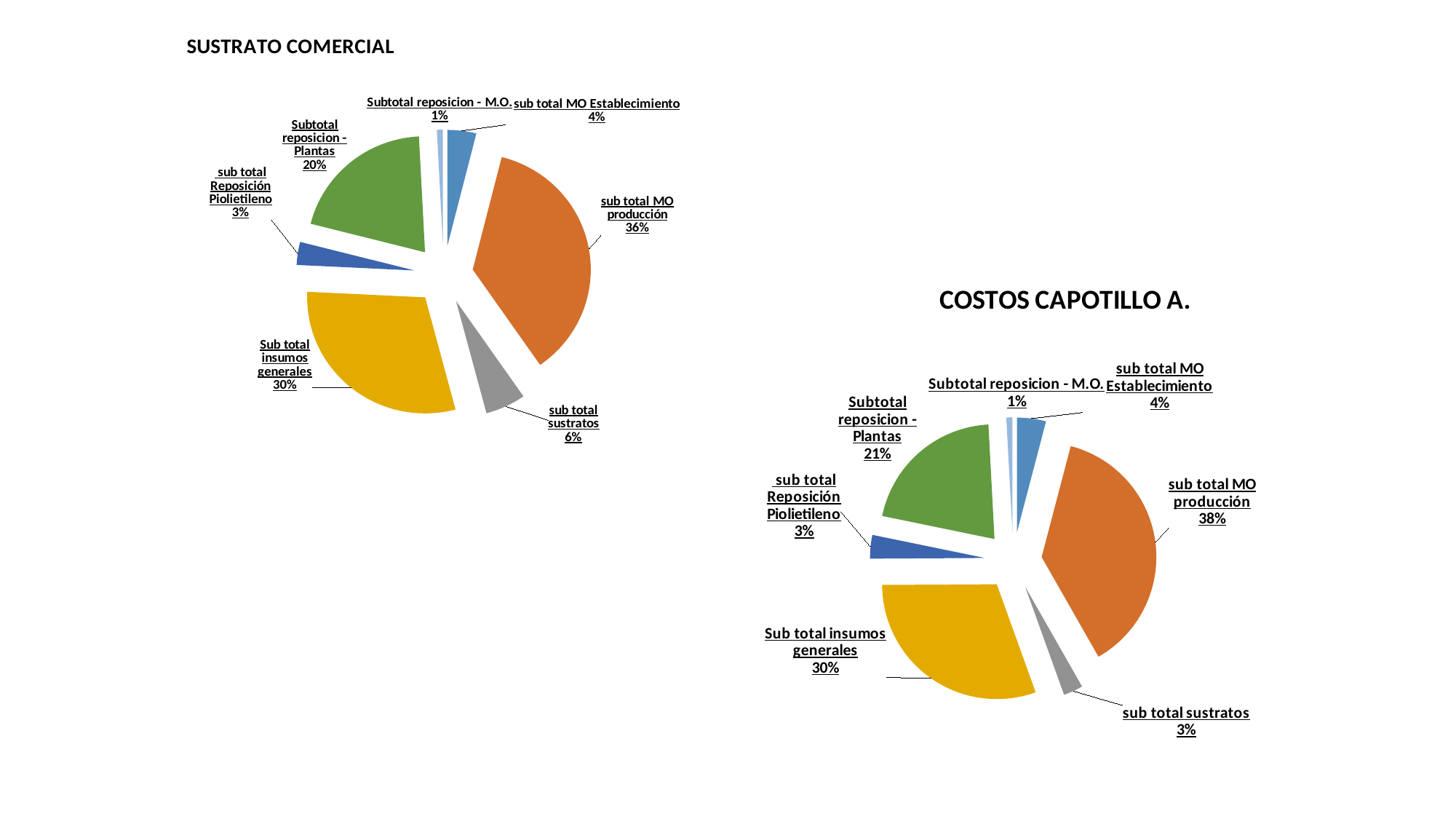
In the SUSTRATO COMERCIAL chart, what share does sub total MO producción have? 36% In the COSTOS CAPOTILLO A. chart, which category has the smallest slice? Subtotal reposicion - M.O. What type of chart is COSTOS CAPOTILLO A.? Pie chart In the COSTOS CAPOTILLO A. chart, what is the value for Subtotal reposicion - Plantas? 21% In the SUSTRATO COMERCIAL chart, which category has the largest slice? sub total MO producción How many slices does the SUSTRATO COMERCIAL chart have? 7 In the COSTOS CAPOTILLO A. chart, which is larger: Subtotal reposicion - Plantas or sub total MO Establecimiento? Subtotal reposicion - Plantas In the SUSTRATO COMERCIAL chart, what is the difference between sub total MO producción and Sub total insumos generales? 6% In the SUSTRATO COMERCIAL chart, what is the value for sub total sustratos? 6% In the SUSTRATO COMERCIAL chart, what is the value for sub total Reposición Piolietileno? 3% In the COSTOS CAPOTILLO A. chart, what share does sub total MO producción have? 38% In the COSTOS CAPOTILLO A. chart, what colour is the sub total MO producción slice? Orange